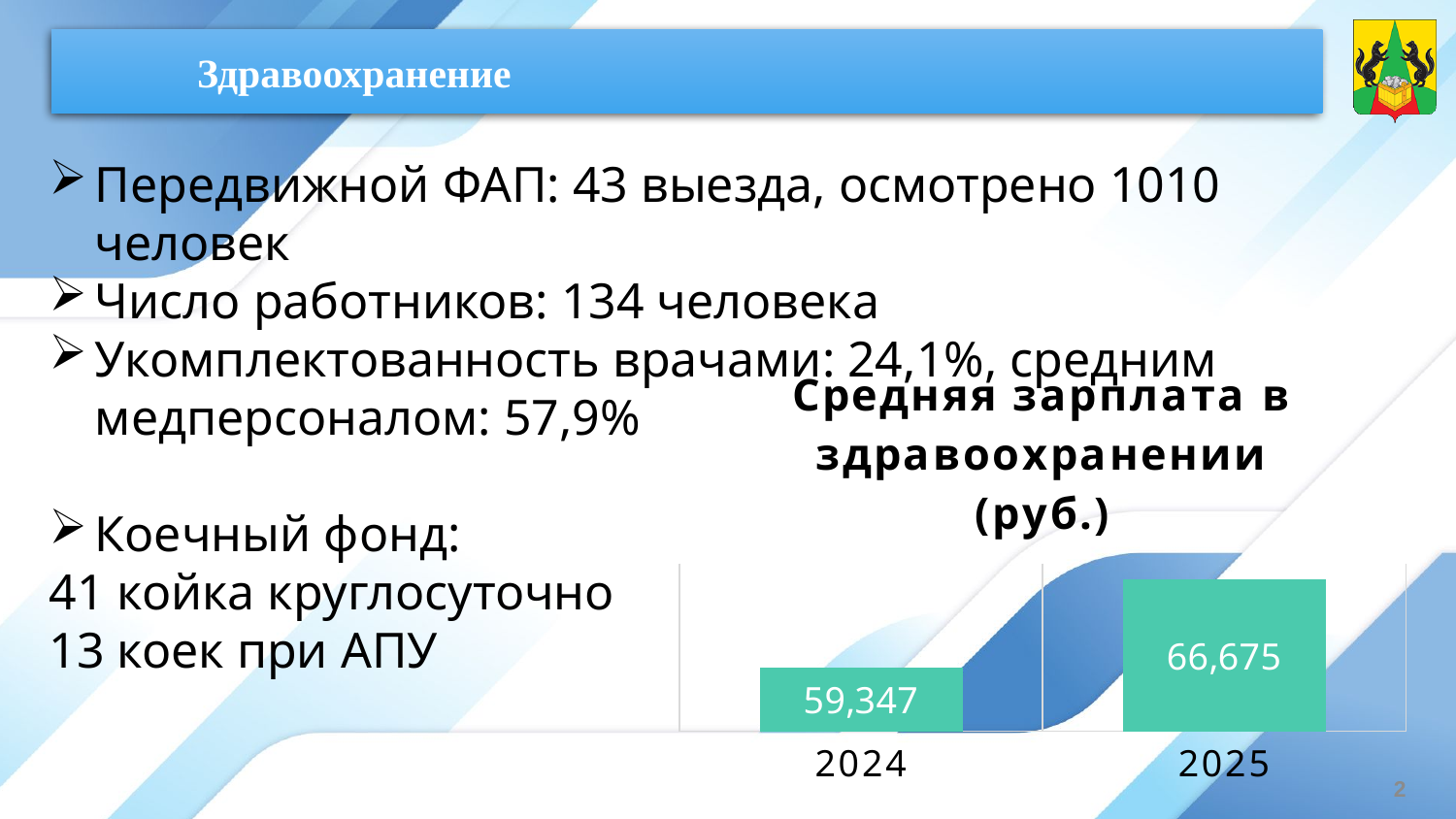
Which year has the higher average healthcare salary? 2025 What type of chart is used to show the average healthcare salary? bar chart In what unit are the values in the chart expressed, according to its title? руб. How many years are plotted in the salary chart? 2 Which year has the lower average healthcare salary? 2024 Does the average healthcare salary rise or fall from 2024 to 2025? rise What is the average healthcare salary shown for 2024? 59,347 What is the average healthcare salary shown for 2025? 66,675 Is the value for 2024 larger or smaller than the value for 2025? smaller What is the title of the chart on the slide? Средняя зарплата в здравоохранении (руб.) By how much does the 2025 value exceed the 2024 value in the salary chart? 7,328